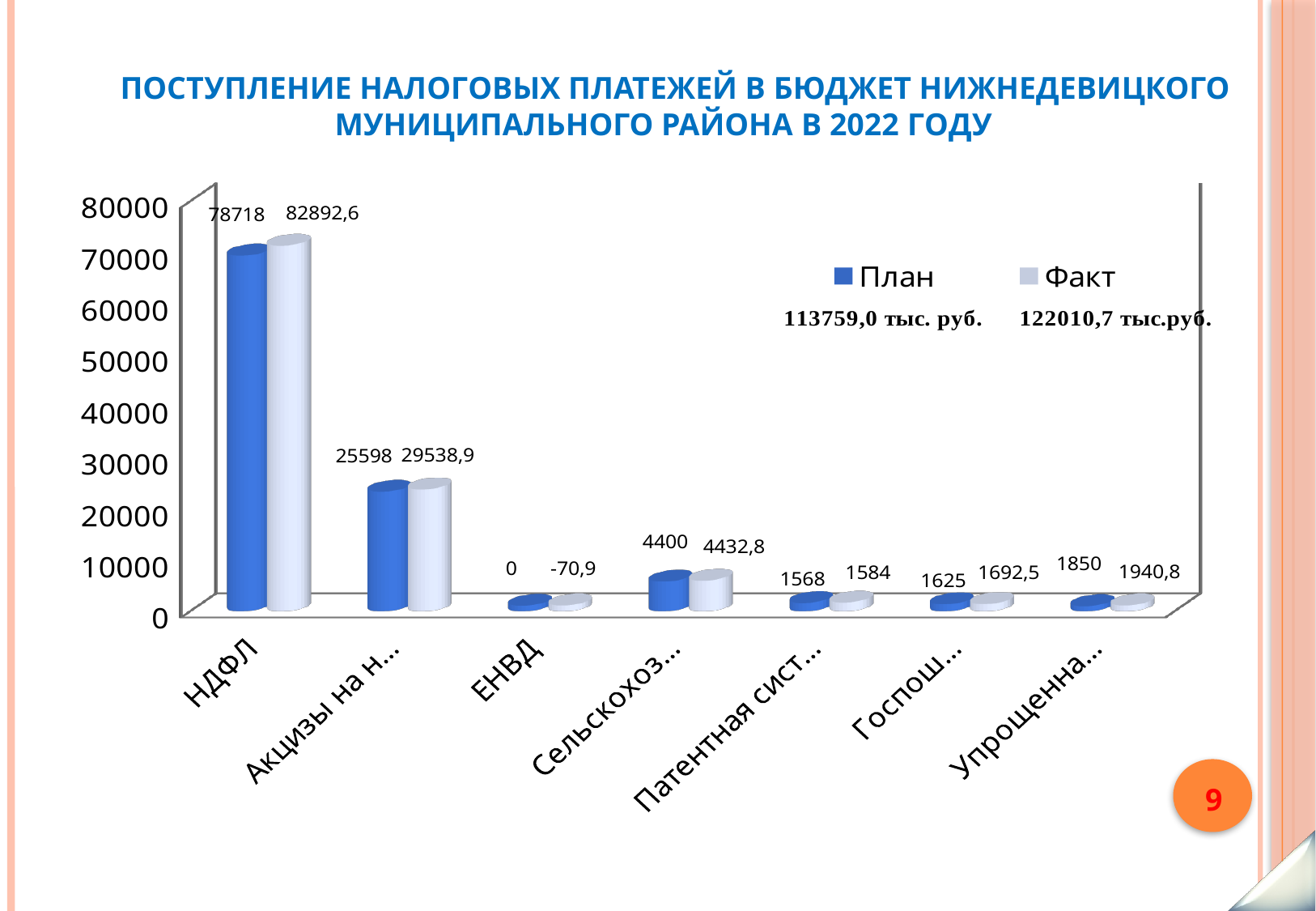
Which is larger for the category labelled 'Акцизы на н...': the План value or the Факт value? Факт What is the План value for the category labelled 'Акцизы на н...'? 25598 What is the difference between the Факт and План values for НДФЛ? 4174,6 What is the План value for НДФЛ? 78718 Which category has the highest План value? НДФЛ What is the Факт value for НДФЛ? 82892,6 How many categories are shown on the x axis? 7 What is the Факт value for ЕНВД? -70,9 Is the Факт value for НДФЛ greater or less than 80000? greater What kind of chart is shown on the slide? bar chart Which category has the lowest Факт value? ЕНВД How many series does the legend list? 2